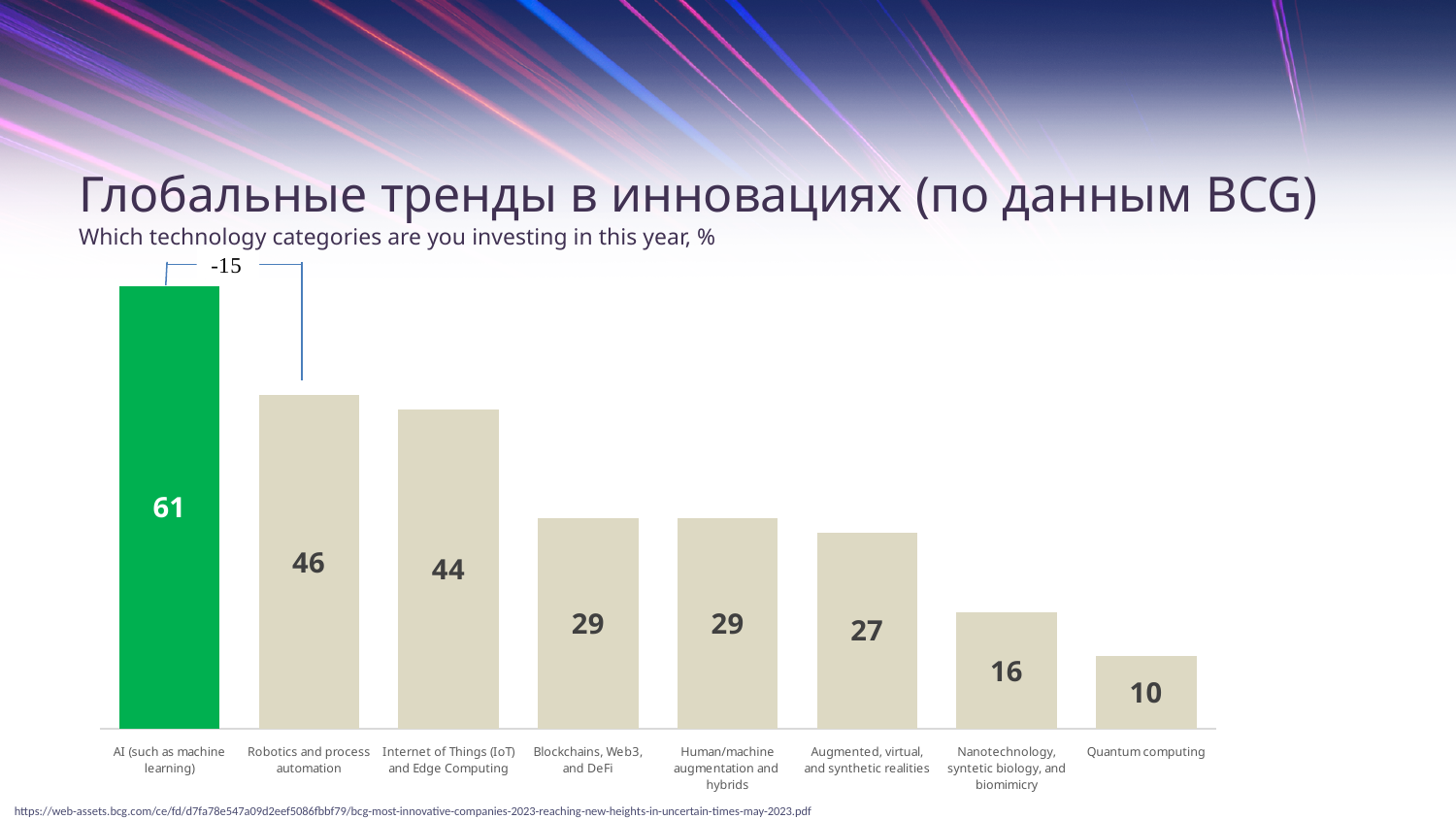
Which category has the lowest value? Quantum computing What is the value for Quantum computing? 10 What is the value for Augmented, virtual, and synthetic realities? 27 Which category has the highest value? AI (such as machine learning) What kind of chart is shown on the slide? Bar chart What is the value for Robotics and process automation? 46 What is the value for AI (such as machine learning)? 61 What is the subtitle of the chart? Which technology categories are you investing in this year, % Which is larger, the value for Internet of Things (IoT) and Edge Computing or the value for Blockchains, Web3, and DeFi? Internet of Things (IoT) and Edge Computing How many categories are shown in the chart? 8 Do the values rise or fall from left to right along the x axis? Fall What is the difference between the values for AI (such as machine learning) and Robotics and process automation? 15